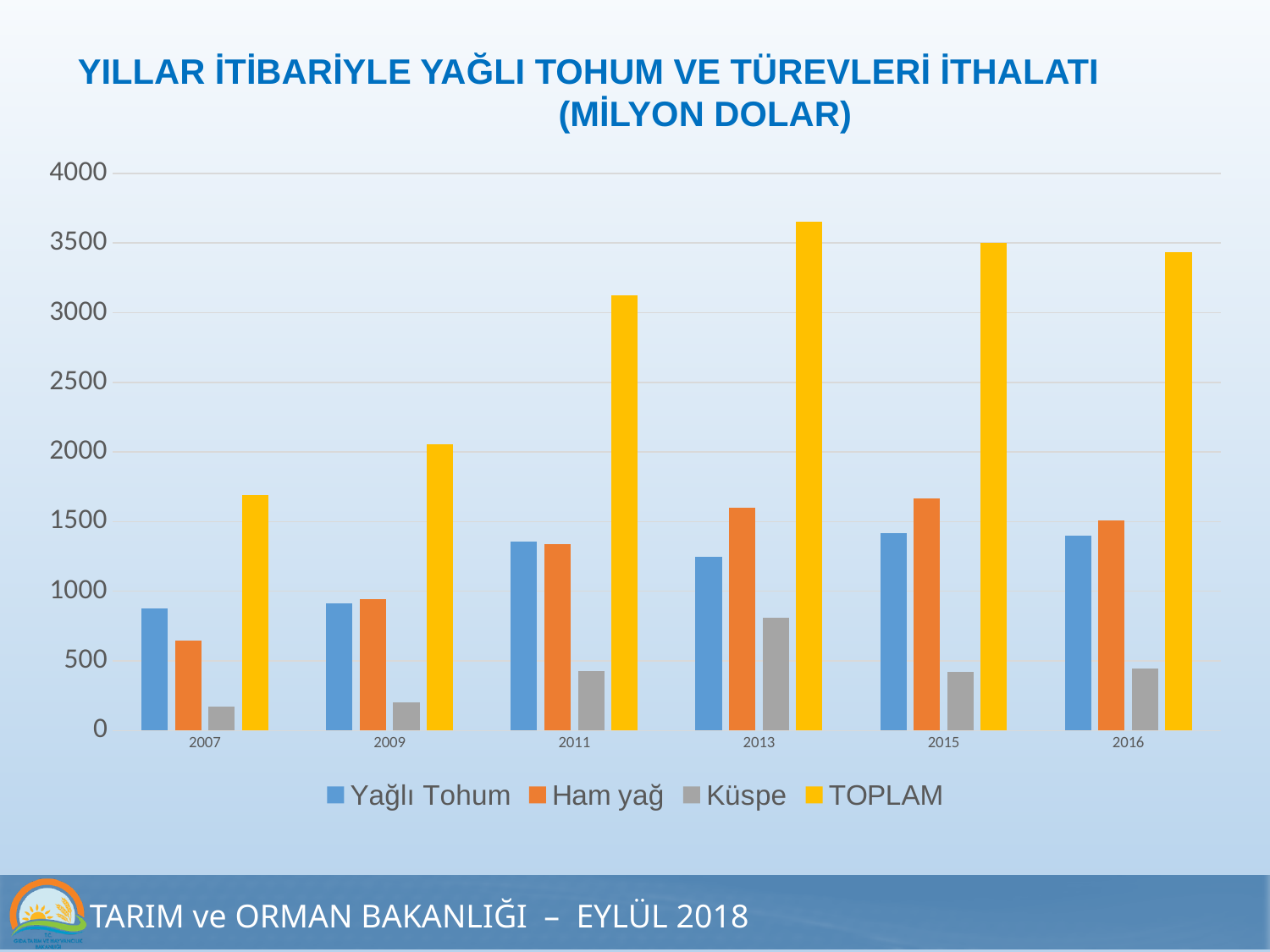
Is the Yağlı Tohum value for 2007 greater or less than 1000? less In 2007, which is larger: Yağlı Tohum or Ham yağ? Yağlı Tohum In which year is the TOPLAM value highest? 2013 How many series does the legend list? 4 In which year is the TOPLAM value lowest? 2007 Does the TOPLAM value rise or fall from 2007 to 2013? rise In which year is the Küspe value lowest? 2007 What kind of chart is shown on the slide? bar chart Is the Küspe value for 2013 greater or less than 500? greater Is the TOPLAM value for 2013 greater or less than 3500? greater How many years are shown on the x axis? 6 In 2013, which is larger: Ham yağ or Yağlı Tohum? Ham yağ